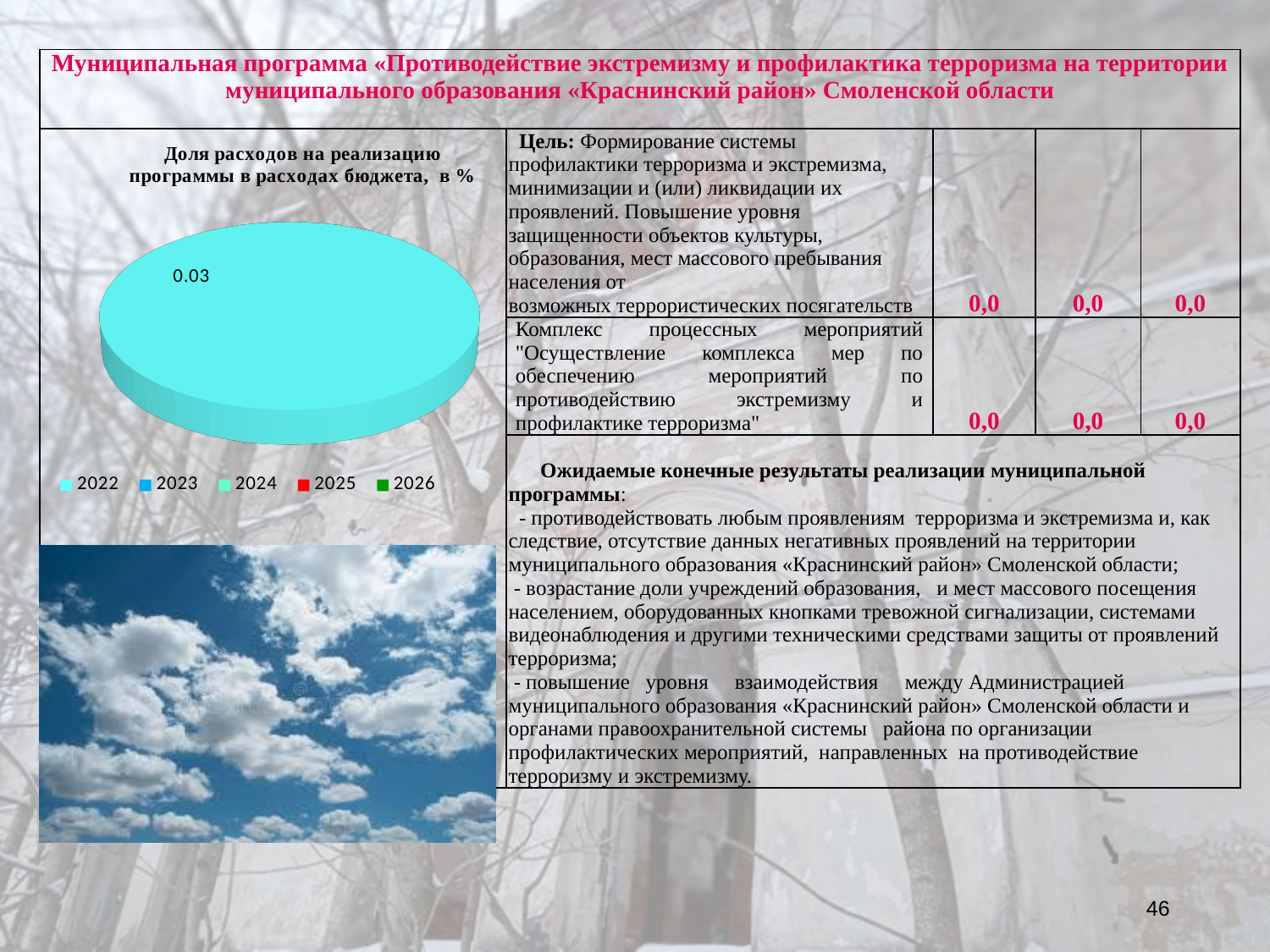
Which years are listed in the legend of the pie chart? 2022, 2023, 2024, 2025, 2026 What kind of chart is shown on the slide? pie chart How many slices are visible in the pie chart? 1 Is the value labelled on the pie chart greater or less than 1? less How many entries does the legend of the pie chart list? 5 What is the title of the chart on the slide? Доля расходов на реализацию программы в расходах бюджета, в % What value is printed as the data label on the pie chart? 0.03